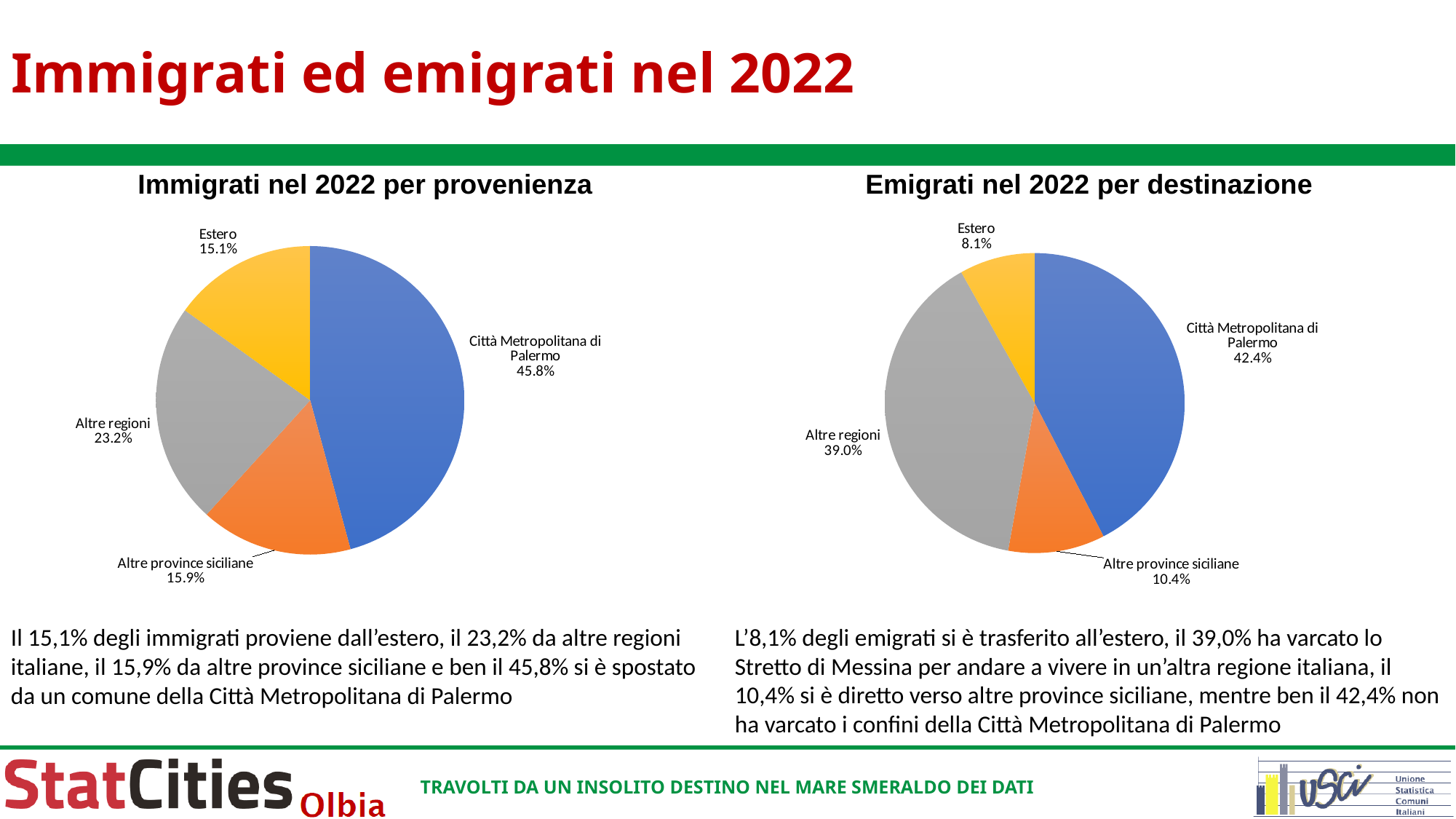
In the 'Emigrati nel 2022 per destinazione' chart, what is the difference in percentage points between Città Metropolitana di Palermo and Altre regioni? 3.4 Which is larger in the 'Emigrati nel 2022 per destinazione' chart: Altre province siciliane or Estero? Altre province siciliane What type of chart is 'Emigrati nel 2022 per destinazione'? Pie chart What is the title of the chart on the left side of the slide? Immigrati nel 2022 per provenienza In the 'Immigrati nel 2022 per provenienza' chart, what is the difference in percentage points between Altre regioni and Altre province siciliane? 7.3 In the 'Emigrati nel 2022 per destinazione' chart, which category has the smallest slice? Estero In the 'Emigrati nel 2022 per destinazione' chart, what share is labelled for Città Metropolitana di Palermo? 42.4% In the 'Emigrati nel 2022 per destinazione' chart, what share is labelled for Altre regioni? 39.0% In the 'Immigrati nel 2022 per provenienza' chart, which category has the largest slice? Città Metropolitana di Palermo How many slices does the 'Immigrati nel 2022 per provenienza' pie chart have? 4 In the 'Immigrati nel 2022 per provenienza' chart, what share is labelled for Estero? 15.1% In the 'Immigrati nel 2022 per provenienza' chart, which category has the smallest slice? Estero